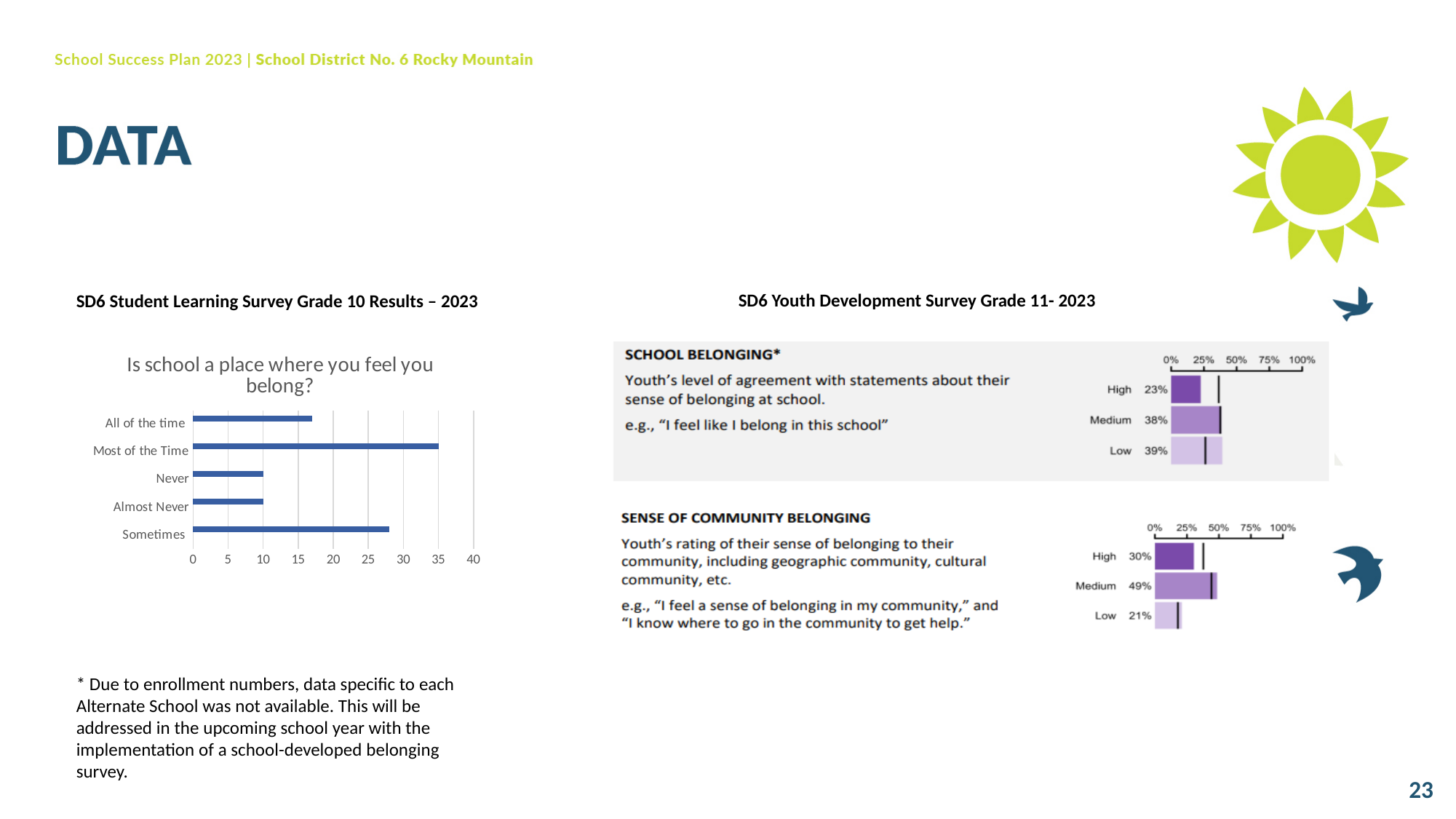
In the Sense of Community Belonging chart, what percentage of youth are in the High category? 30% In the Sense of Community Belonging chart, which category has the highest percentage? Medium In the Sense of Community Belonging chart, what is the difference between the Medium and Low percentages? 28% What kind of chart is the 'Is school a place where you feel you belong?' chart? bar chart In the 'Is school a place where you feel you belong?' chart, is the value for All of the time greater or less than 20? less In the School Belonging chart, what percentage of youth are in the High category? 23% In the 'Is school a place where you feel you belong?' chart, is the value for Sometimes greater or less than 25? greater How many categories does the 'Is school a place where you feel you belong?' chart show? 5 In the 'Is school a place where you feel you belong?' chart, which is larger, Sometimes or All of the time? Sometimes In the 'Is school a place where you feel you belong?' chart, which category has the highest value? Most of the Time In the School Belonging chart, what percentage of youth are in the Low category? 39% What is the title of the bar chart on the left side of the slide? Is school a place where you feel you belong?